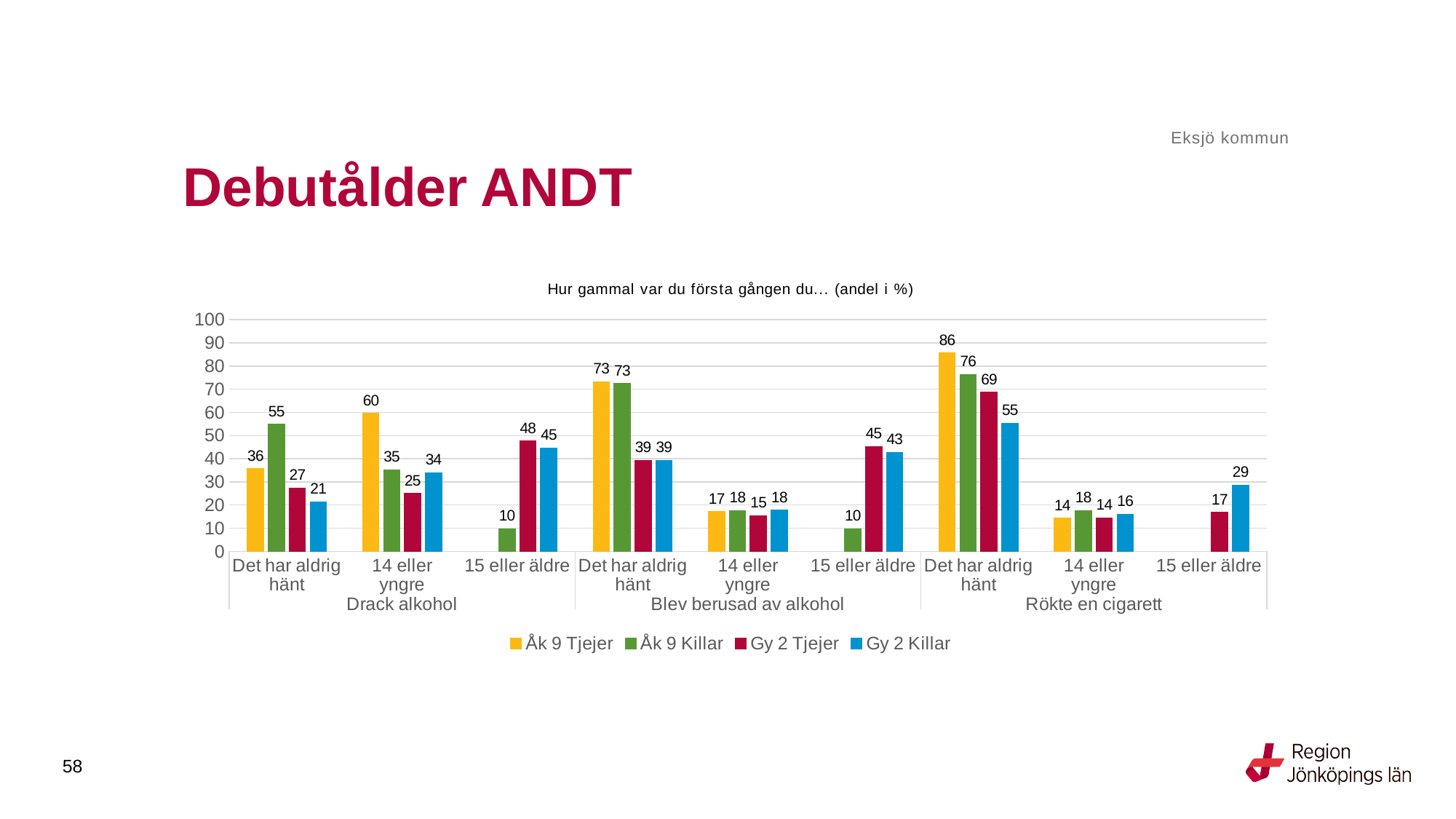
What is the difference between Åk 9 Tjejer and Åk 9 Killar in the '14 eller yngre' category under 'Drack alkohol'? 25 Which series has the lowest value in the 'Det har aldrig hänt' category under 'Drack alkohol'? Gy 2 Killar How many series does the legend list? 4 Is the value for Åk 9 Killar in the 'Det har aldrig hänt' category under 'Rökte en cigarett' greater or less than 70? greater Which is larger: Gy 2 Tjejer or Gy 2 Killar in the '15 eller äldre' category under 'Drack alkohol'? Gy 2 Tjejer What is the value for Åk 9 Tjejer in the 'Det har aldrig hänt' category under 'Drack alkohol'? 36 What is the difference between Åk 9 Tjejer and Gy 2 Killar in the 'Det har aldrig hänt' category under 'Rökte en cigarett'? 31 What is the value for Gy 2 Tjejer in the '14 eller yngre' category under 'Blev berusad av alkohol'? 15 What is the title of the chart? Hur gammal var du första gången du… (andel i %) What is the value for Gy 2 Killar in the '15 eller äldre' category under 'Rökte en cigarett'? 29 What kind of chart is shown on the slide? Bar chart Which series has the highest value in the 'Det har aldrig hänt' category under 'Rökte en cigarett'? Åk 9 Tjejer